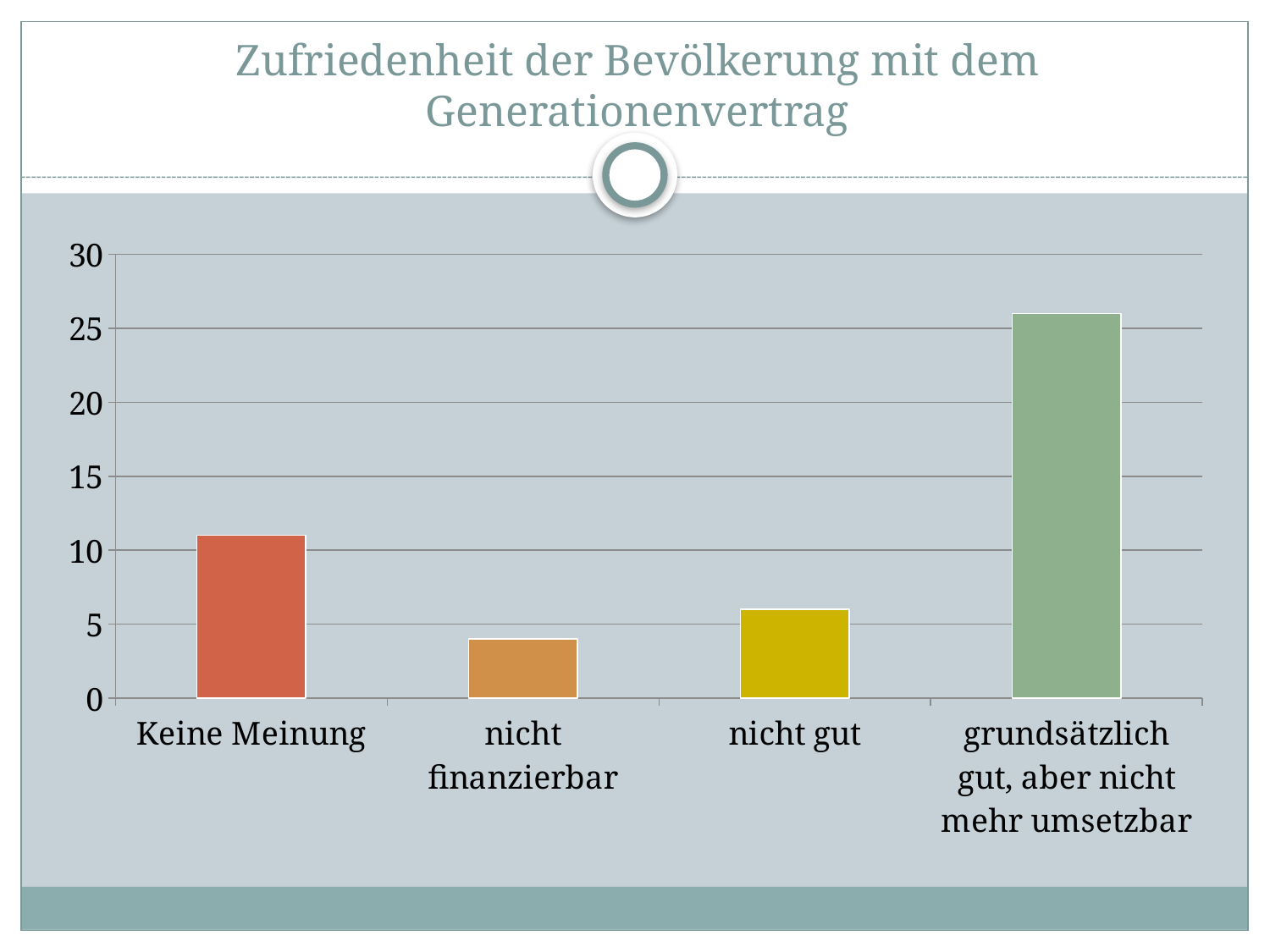
Which category has the highest bar? grundsätzlich gut, aber nicht mehr umsetzbar What is the highest value shown on the y axis of the chart? 30 How many categories are shown on the x axis of the chart? 4 Which is larger, the value for nicht finanzierbar or the value for nicht gut? nicht gut Is the value for nicht finanzierbar greater or less than 5? less Which category has the lowest bar? nicht finanzierbar What is the title of the slide containing the chart? Zufriedenheit der Bevölkerung mit dem Generationenvertrag Is the value for Keine Meinung greater or less than 10? greater What kind of chart is shown on the slide? bar chart Which is larger, the value for Keine Meinung or the value for nicht gut? Keine Meinung Is the value for nicht gut greater or less than 5? greater